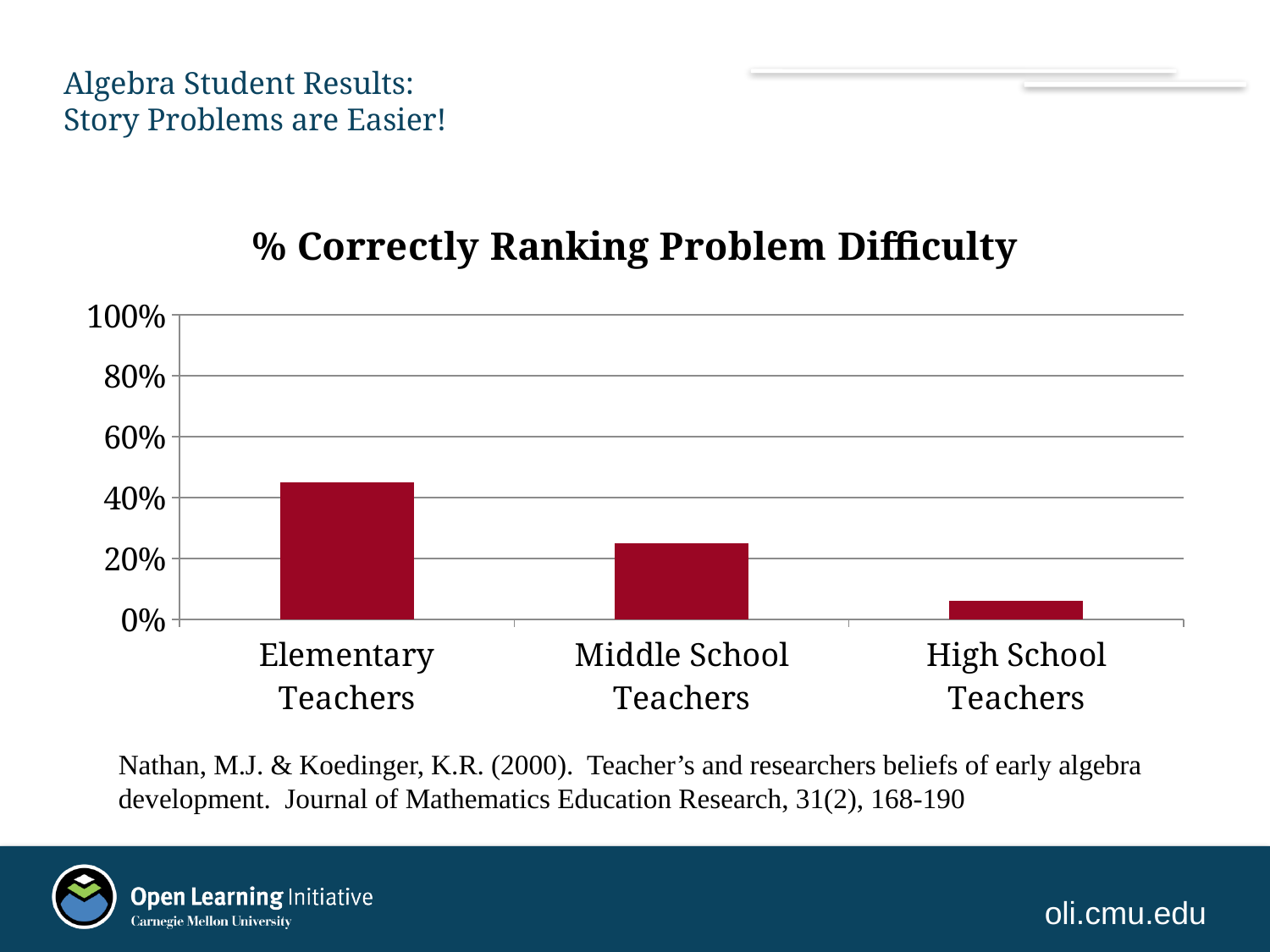
Which is larger, the value for Elementary Teachers or the value for Middle School Teachers? Elementary Teachers What kind of chart is shown on the slide? Bar chart Is the value for Elementary Teachers greater or less than 60%? less Which is larger, the value for Middle School Teachers or the value for High School Teachers? Middle School Teachers Is the value for Elementary Teachers greater or less than 40%? greater Is the value for High School Teachers greater or less than 20%? less What is the title of the chart? % Correctly Ranking Problem Difficulty Do the values rise or fall moving from Elementary Teachers to High School Teachers along the x axis? fall How many categories are shown on the x axis of the chart? 3 Which category has the lowest value in the chart? High School Teachers Which category has the highest value in the chart? Elementary Teachers